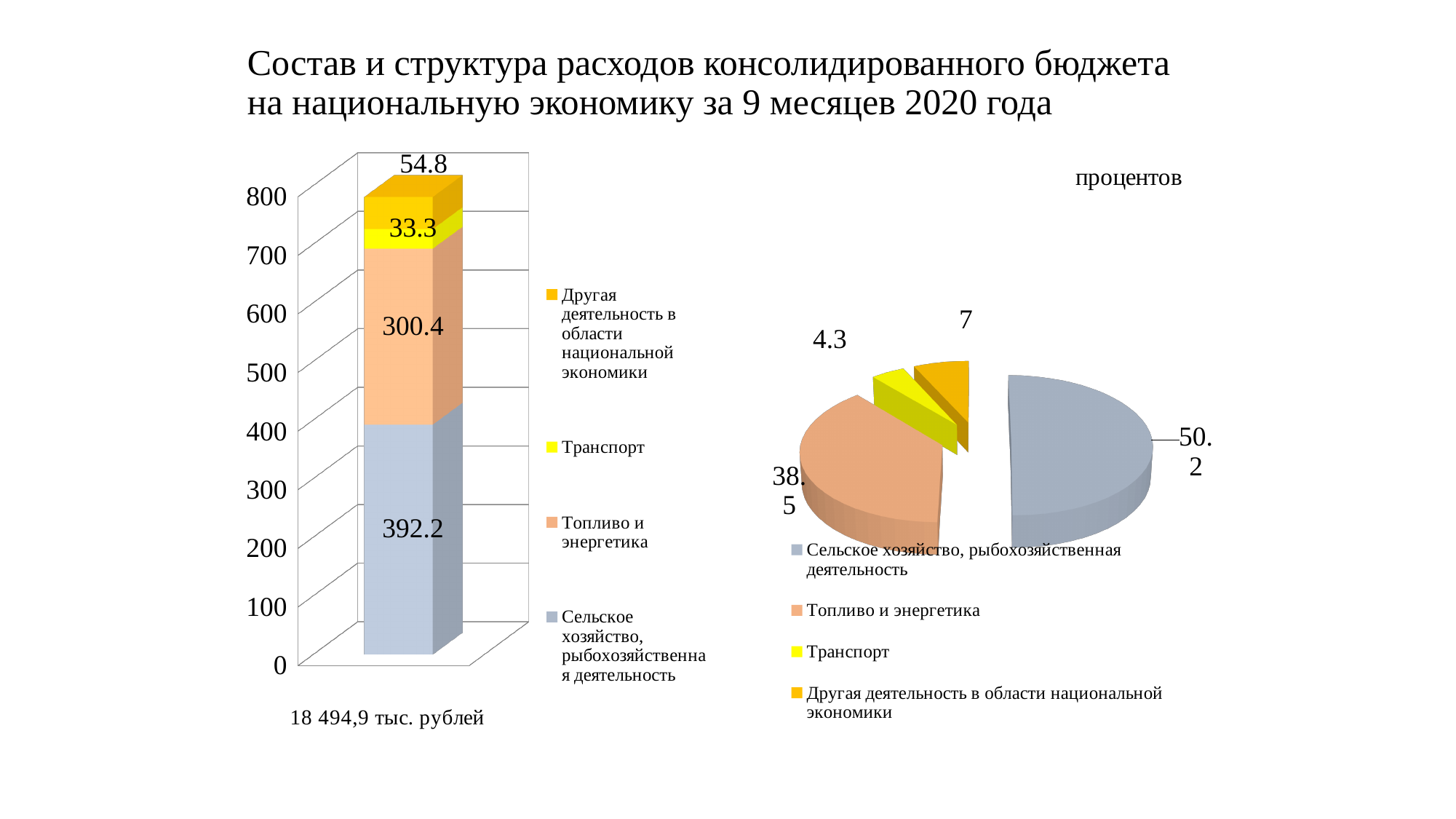
In the pie chart on the right, what is the share for Топливо и энергетика? 38.5 In the stacked bar chart on the left, what is the difference between the values for Сельское хозяйство, рыбохозяйственная деятельность and Топливо и энергетика? 91.8 In the stacked bar chart on the left, what is the value for Сельское хозяйство, рыбохозяйственная деятельность? 392.2 In the stacked bar chart on the left, what is the value for Топливо и энергетика? 300.4 In the stacked bar chart on the left, how many series does the legend list? 4 In the pie chart on the right, which slice is the largest? Сельское хозяйство, рыбохозяйственная деятельность In the stacked bar chart on the left, what is the total of all segments in the bar? 780.7 What type of chart is shown on the right side of the slide? Pie chart In the stacked bar chart on the left, what is the value for Транспорт? 33.3 In the stacked bar chart on the left, which segment has the smallest value? Транспорт In the stacked bar chart on the left, which segment has the largest value? Сельское хозяйство, рыбохозяйственная деятельность In the pie chart on the right, what is the share for Другая деятельность в области национальной экономики? 7